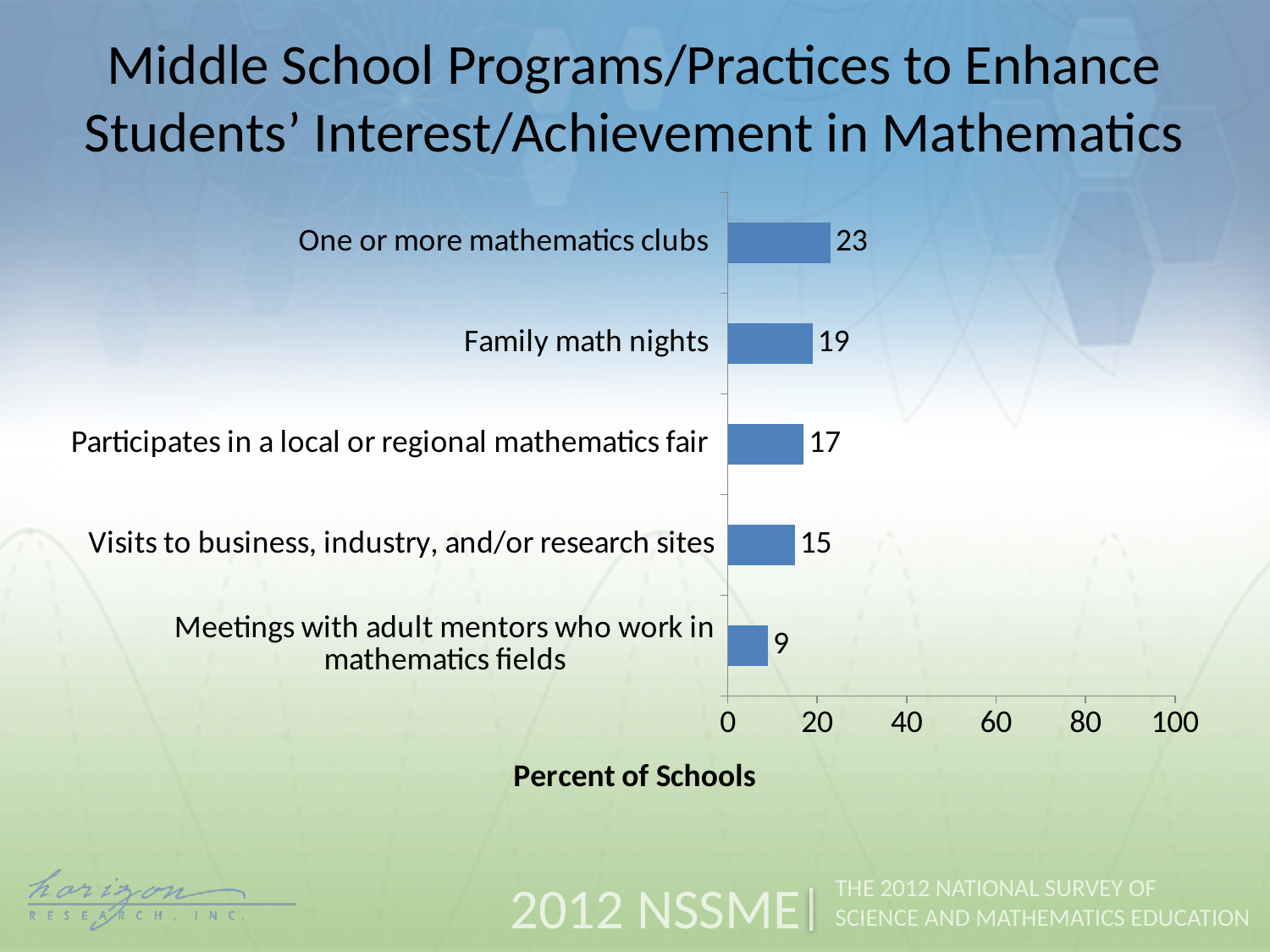
What is the difference between the values for One or more mathematics clubs and Family math nights? 4 Which is larger: the value for Family math nights or the value for Visits to business, industry, and/or research sites? Family math nights What percent of schools report meetings with adult mentors who work in mathematics fields? 9 What is the value for Family math nights? 19 Which program/practice has the highest percent of schools? One or more mathematics clubs How many programs/practices are shown in the chart? 5 Is the value for One or more mathematics clubs greater or less than 20? greater What is the difference between the values for Participates in a local or regional mathematics fair and Visits to business, industry, and/or research sites? 2 What percent of schools have one or more mathematics clubs? 23 Which program/practice has the lowest percent of schools? Meetings with adult mentors who work in mathematics fields What kind of chart is shown on the slide? Bar chart What is the label of the horizontal axis? Percent of Schools